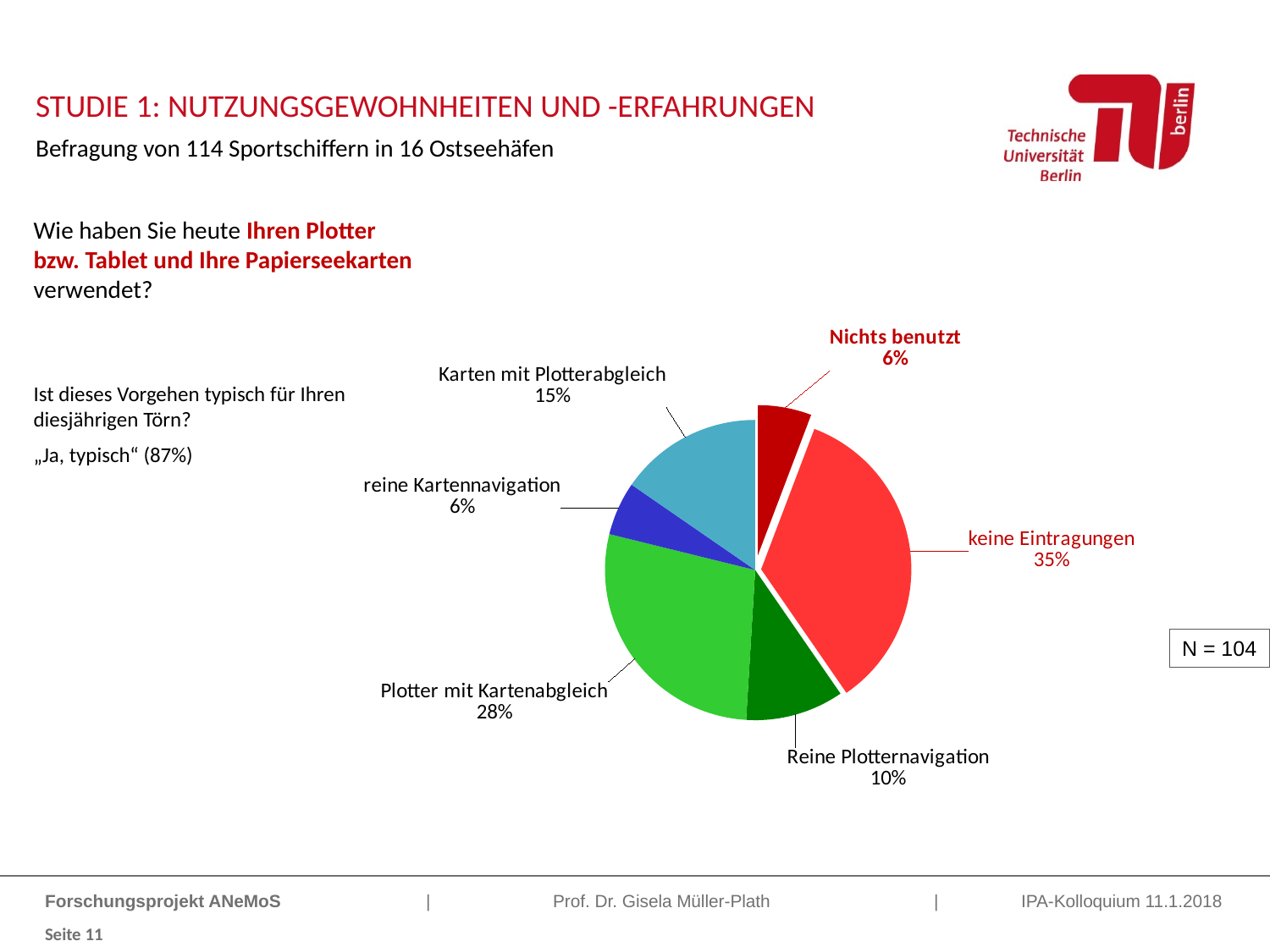
What is the combined share of "reine Kartennavigation" and "Nichts benutzt"? 12% What share of the pie is labelled "keine Eintragungen"? 35% What kind of chart is shown on the slide? pie chart What share of the pie is labelled "Reine Plotternavigation"? 10% What sample size (N) is stated next to the pie chart? N = 104 Which is larger, the share for "Plotter mit Kartenabgleich" or the share for "Karten mit Plotterabgleich"? Plotter mit Kartenabgleich What share of the pie is labelled "Karten mit Plotterabgleich"? 15% How many slices does the pie chart have? 6 What is the difference in percentage points between "keine Eintragungen" and "Plotter mit Kartenabgleich"? 7 percentage points Which category has the largest share of the pie? keine Eintragungen